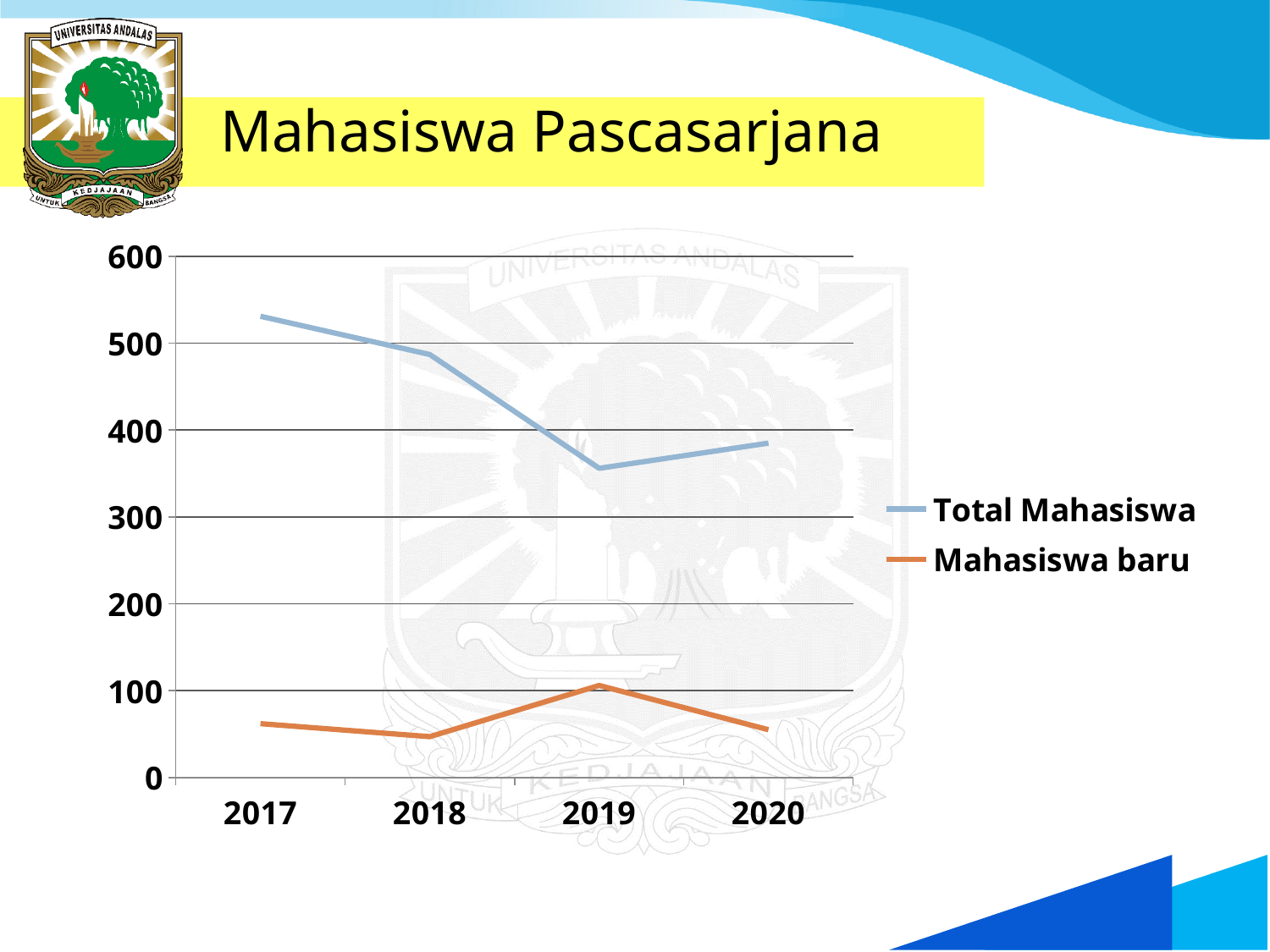
Does Total Mahasiswa rise or fall from 2017 to 2019? fall How many years are plotted along the x axis? 4 What is the title of the slide containing the chart? Mahasiswa Pascasarjana What kind of chart is shown on the slide? line chart How many series does the legend list? 2 Is the value for Mahasiswa baru in 2018 greater or less than 100? less In which year is Total Mahasiswa lowest? 2019 Is the value for Total Mahasiswa in 2019 greater or less than 400? less Which series is drawn in orange? Mahasiswa baru In which year is Mahasiswa baru highest? 2019 Is the value for Total Mahasiswa in 2017 greater or less than 500? greater In which year is Total Mahasiswa highest? 2017